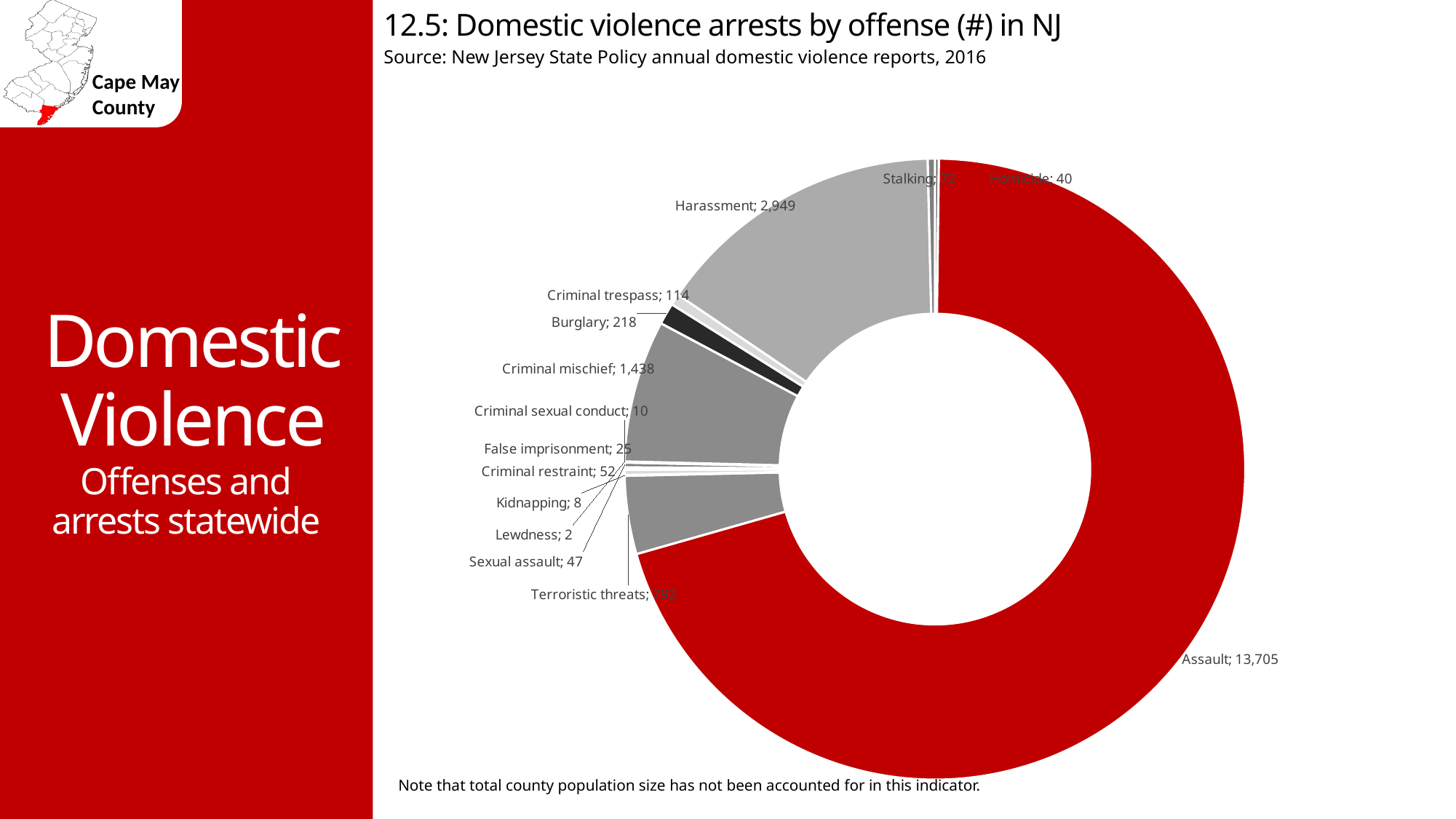
What is the value for Criminal trespass? 114 What is the value for Sexual assault? 47 What is the value for Harassment? 2,949 What is the difference between the Harassment and Criminal mischief values? 1,511 How many offense categories are shown in the chart? 14 Which is larger, Burglary or Criminal trespass? Burglary How many domestic violence arrests for Assault are shown? 13,705 What is the value for Burglary? 218 What kind of chart is shown on the slide? doughnut chart Which offense has the lowest number of arrests? Lewdness What is the value for Criminal mischief? 1,438 Which offense has the highest number of arrests? Assault